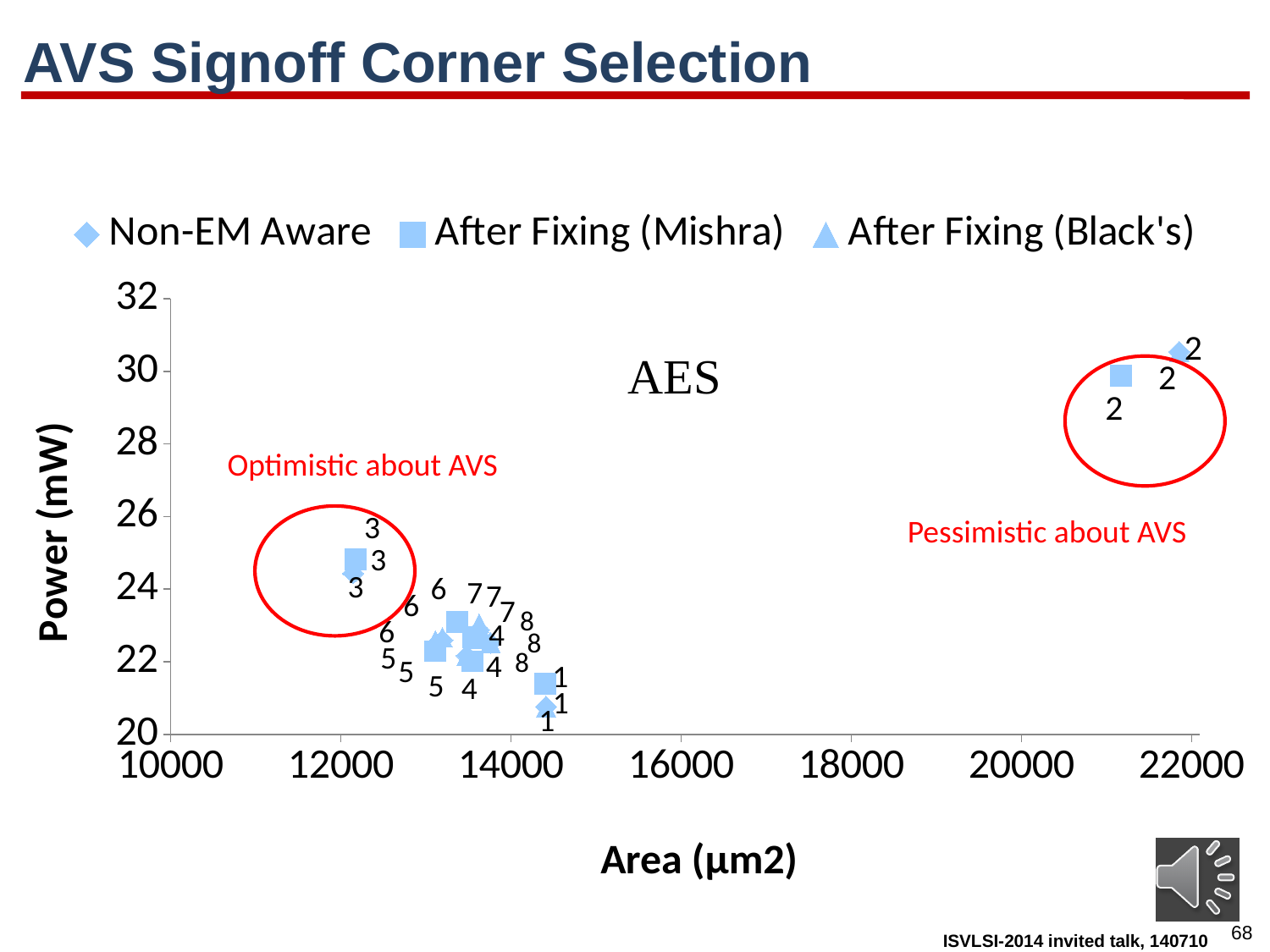
What kind of chart is shown on the slide? scatter chart What are the three series named in the chart legend? Non-EM Aware, After Fixing (Mishra), After Fixing (Black's) Which has the larger area: the points labelled 2 or the points labelled 3? 2 How many series does the chart legend list? 3 Which point label has the highest power in the chart? 2 How many distinct numbered point labels (1 through 8) appear in the chart? 8 Is the power value for the Non-EM Aware point labelled 2 greater or less than 28 mW? greater Is the area value for the points labelled 3 greater or less than 14000? less What are the two red annotations written inside the chart? Optimistic about AVS; Pessimistic about AVS Is the power value for the Non-EM Aware point labelled 1 greater or less than 22 mW? less Which point label has the lowest power in the chart? 1